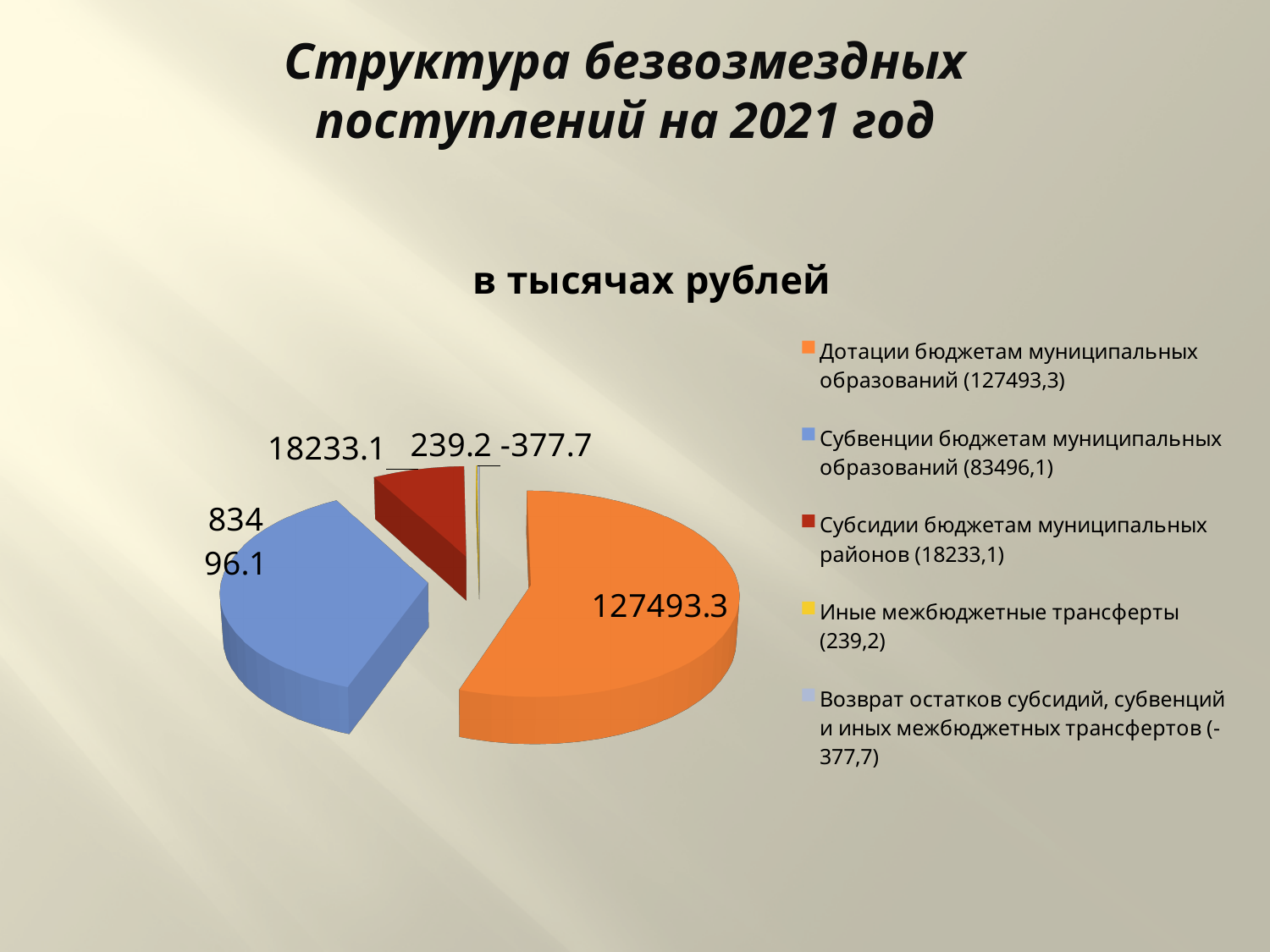
What is the title of the chart? в тысячах рублей Which is larger: Субсидии бюджетам муниципальных районов or Иные межбюджетные трансферты? Субсидии бюджетам муниципальных районов What is the value shown for Иные межбюджетные трансферты? 239.2 According to the legend, what value is given for Субвенции бюджетам муниципальных образований? 83496,1 What kind of chart is shown on the slide? Pie chart What is the difference between the values for Субсидии бюджетам муниципальных районов and Иные межбюджетные трансферты? 17993.9 What is the value shown for Дотации бюджетам муниципальных образований? 127493.3 What is the value shown for Субсидии бюджетам муниципальных районов? 18233.1 Which category has the lowest value? Возврат остатков субсидий, субвенций и иных межбюджетных трансфертов How many categories does the pie chart have? 5 What is the value shown for Возврат остатков субсидий, субвенций и иных межбюджетных трансфертов? -377.7 Which category has the highest value? Дотации бюджетам муниципальных образований